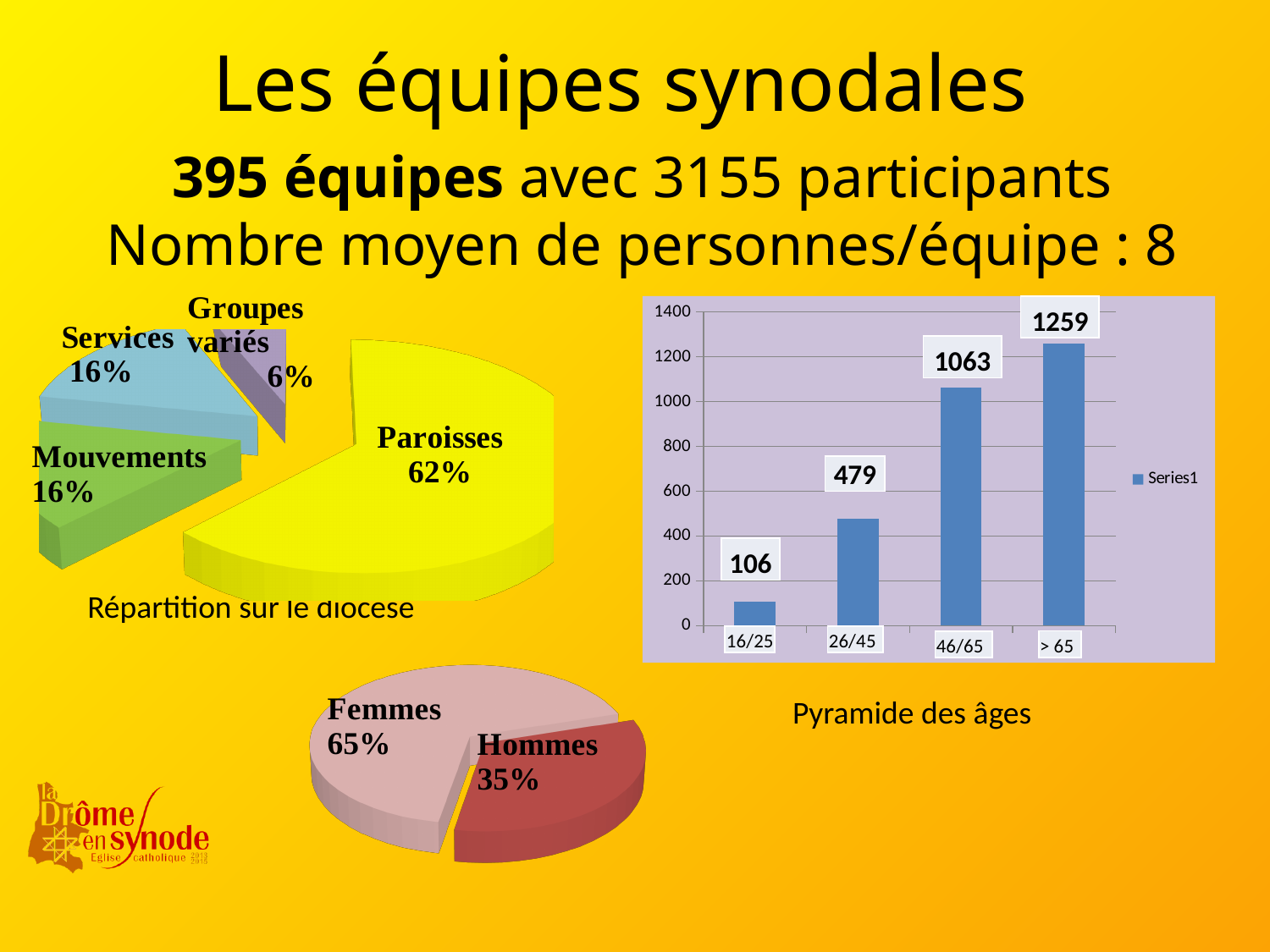
In the pie chart at the bottom of the slide, which is larger, 'Femmes' or 'Hommes'? Femmes What kind of chart is 'Pyramide des âges'? bar chart In the 'Répartition sur le diocèse' pie chart, what share does 'Paroisses' have? 62% In the 'Pyramide des âges' bar chart, how many age categories are shown? 4 In the 'Pyramide des âges' bar chart, do the values rise or fall from left to right along the x axis? rise In the 'Répartition sur le diocèse' pie chart, which category has the smallest share? Groupes variés In the 'Pyramide des âges' bar chart, which age category has the lowest value? 16/25 In the 'Pyramide des âges' bar chart, what is the value for the '16/25' category? 106 In the 'Pyramide des âges' bar chart, what is the value for the '> 65' category? 1259 In the 'Répartition sur le diocèse' pie chart, how many categories are shown? 4 In the 'Pyramide des âges' bar chart, what is the difference between the '46/65' and '26/45' values? 584 In the pie chart at the bottom of the slide, what share do 'Hommes' have? 35%